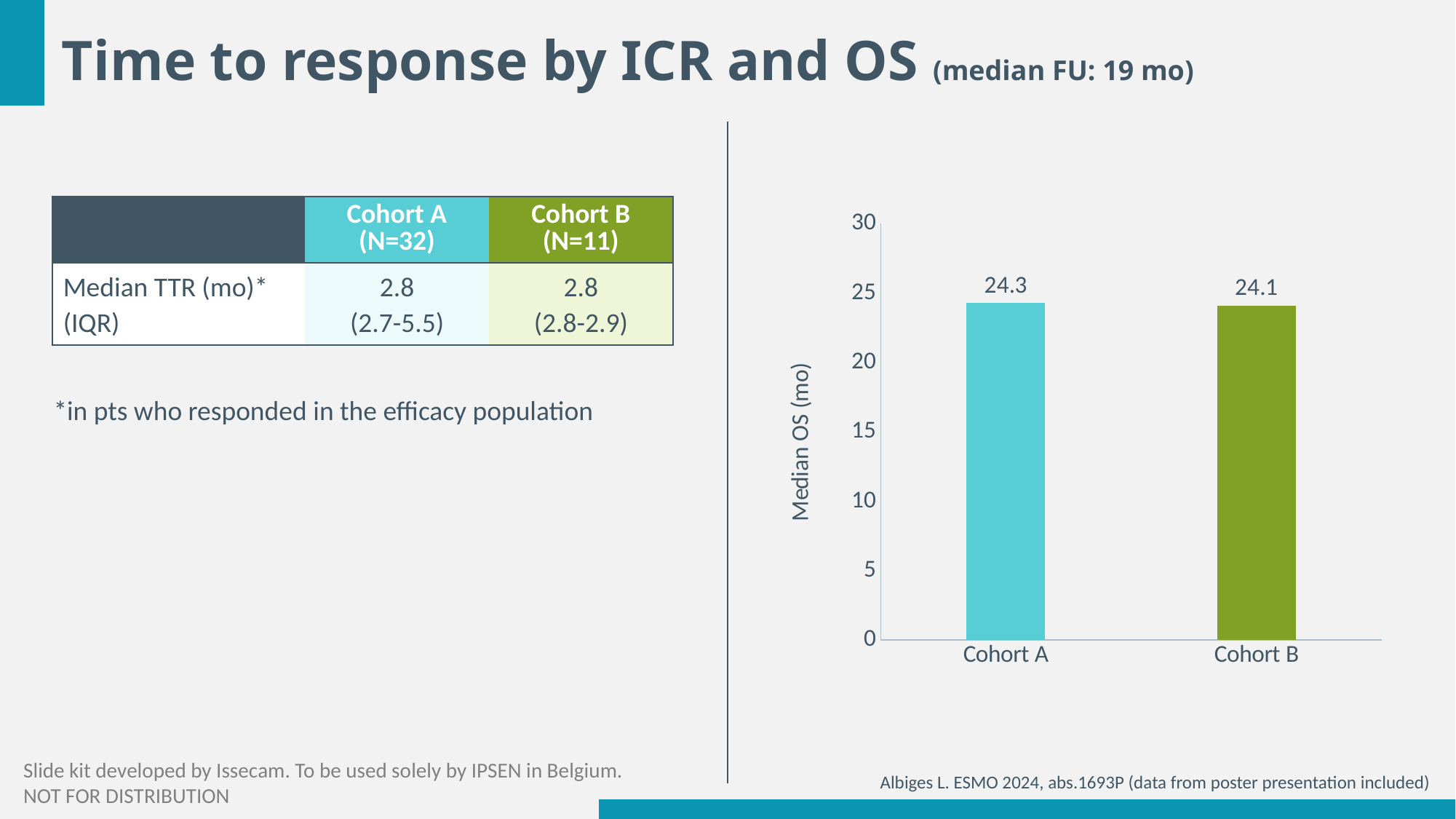
What is the median OS (mo) for Cohort B? 24.1 What is the maximum value shown on the y axis of the chart? 30 Which cohort has the higher median OS? Cohort A What is the label of the y axis of the chart? Median OS (mo) How many cohorts are plotted in the chart? 2 What is the median OS (mo) for Cohort A? 24.3 What is the difference in median OS (mo) between Cohort A and Cohort B? 0.2 Is the median OS for Cohort B greater or less than 25? less Which cohort has the lower median OS? Cohort B Is the median OS for Cohort A greater or less than 20? greater What kind of chart is shown on the slide? bar chart